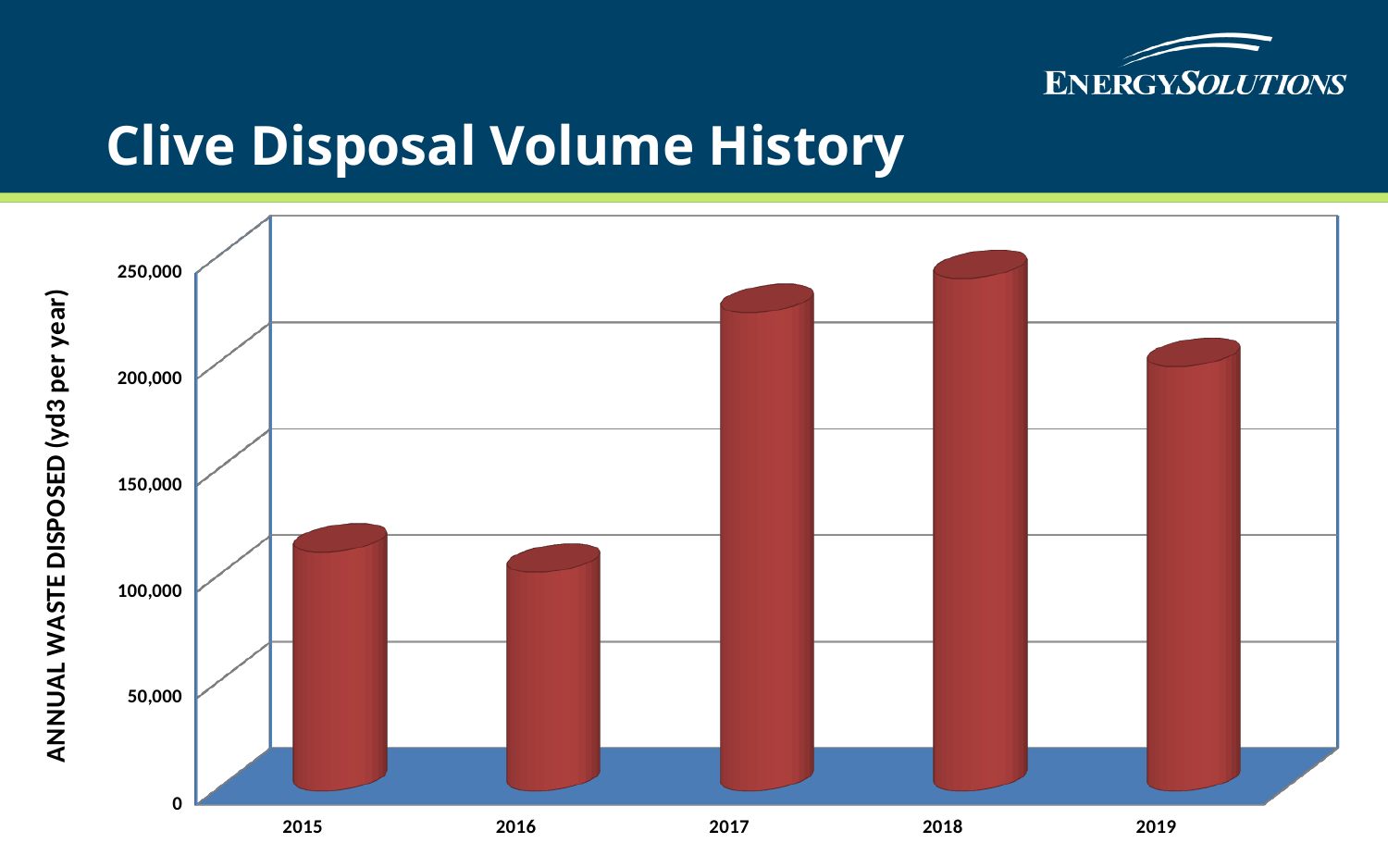
What is the label on the vertical axis of the chart? ANNUAL WASTE DISPOSED (yd3 per year) From 2016 to 2018, do the values rise or fall? rise Is the value for 2015 greater or less than 150,000? less Which year has the larger annual waste disposed, 2015 or 2017? 2017 Is the value for 2017 greater or less than 200,000? greater Which year has the highest annual waste disposed? 2018 Which year has the larger annual waste disposed, 2017 or 2019? 2017 Is the value for 2019 greater or less than 150,000? greater What kind of chart is shown on the slide? bar chart How many years are shown on the x axis of the chart? 5 Which year has the lowest annual waste disposed? 2016